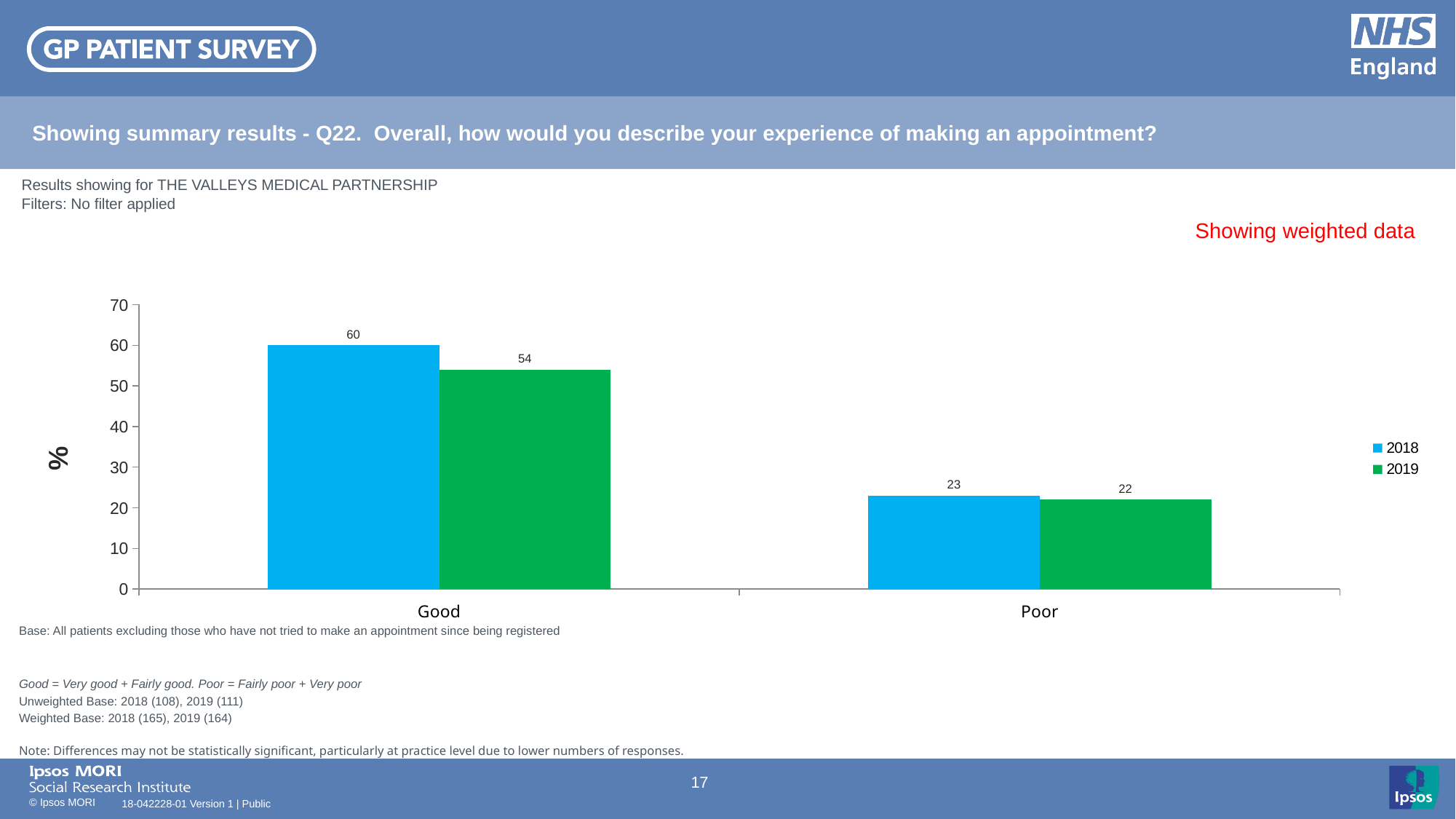
What kind of chart is shown on the slide? Bar chart What is the value for Good in 2019? 54 How many categories are shown on the x axis? 2 What is the value for Poor in 2019? 22 What label is shown on the y axis? % What is the value for Good in 2018? 60 Which is larger for Good: the 2018 value or the 2019 value? 2018 What is the value for Poor in 2018? 23 How many series does the legend list? 2 What is the difference between the 2018 and 2019 values for Good? 6 Which category has the highest value in 2019? Good Which category has the lowest value in 2018? Poor